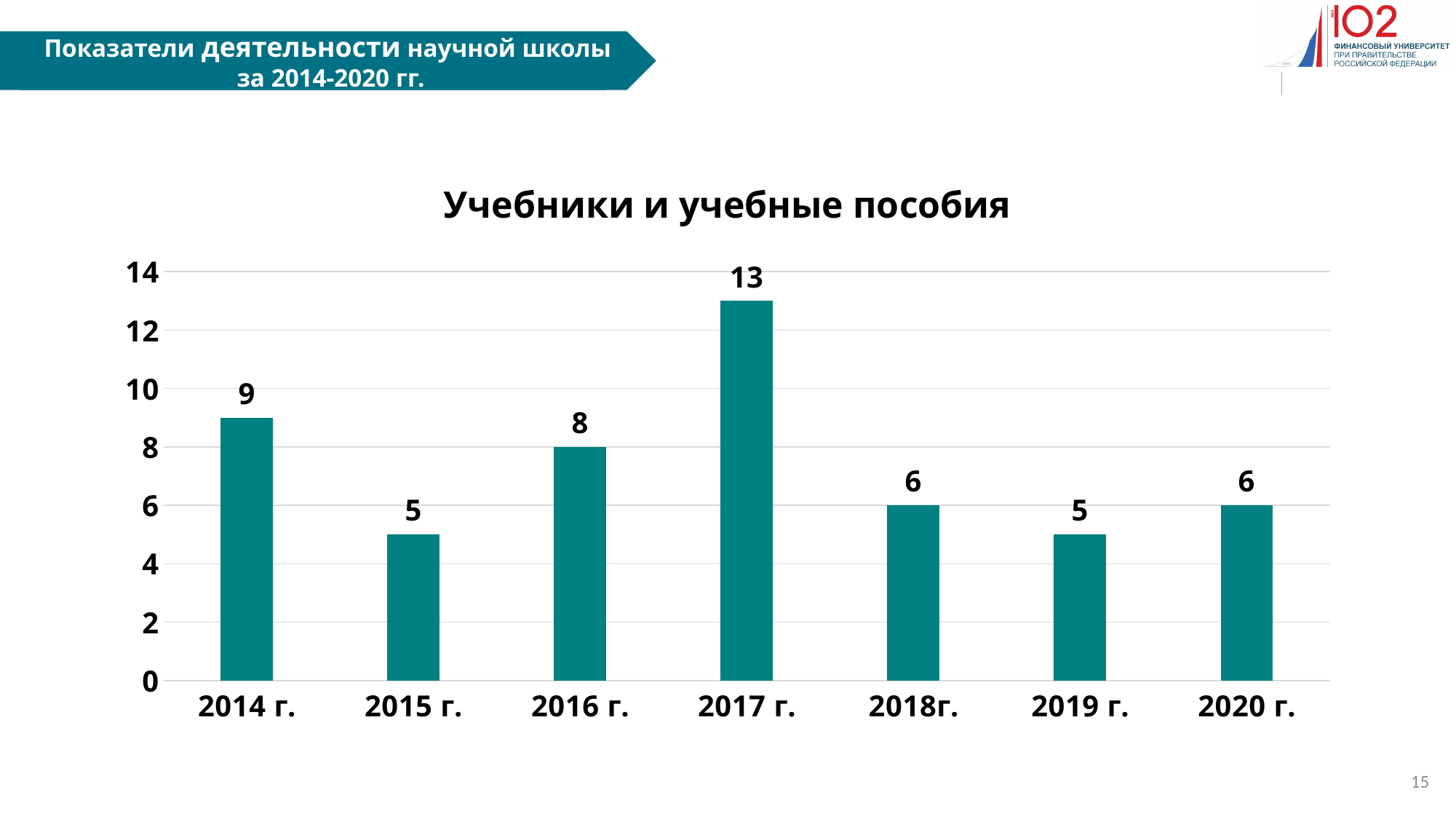
What is the difference between the values for 2014 г. and 2015 г.? 4 What is the value for 2017 г.? 13 What is the title of the chart? Учебники и учебные пособия Which year has the highest value? 2017 г. What is the value for 2014 г.? 9 Which is larger, the value for 2016 г. or the value for 2018г.? 2016 г. Do the values rise or fall from 2017 г. to 2018г.? fall How many years are shown on the x axis? 7 What is the value for 2019 г.? 5 What is the difference between the values for 2017 г. and 2016 г.? 5 Is the value for 2017 г. greater or less than 12? greater What kind of chart is shown on the slide? bar chart